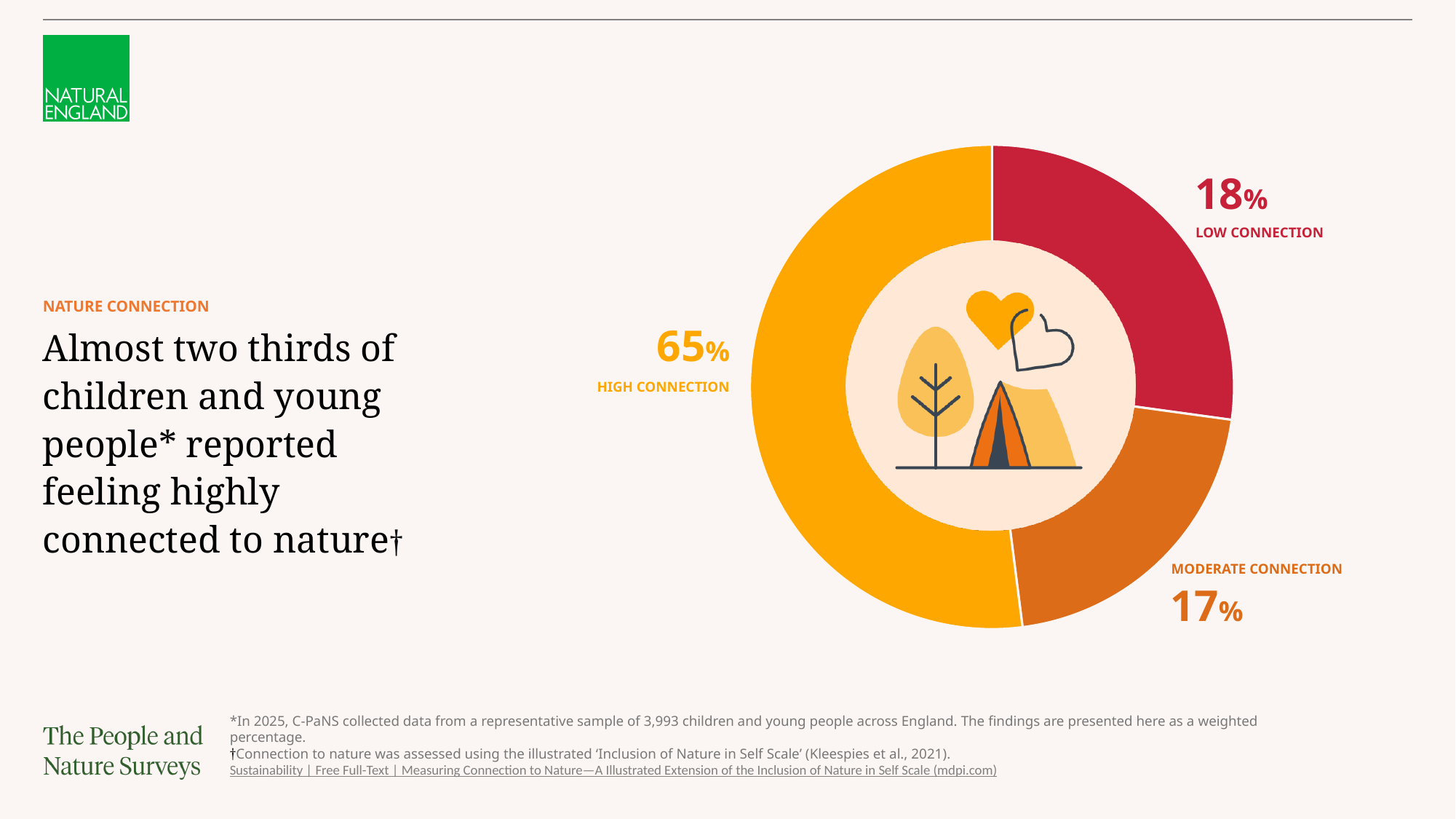
What percentage of children and young people reported a low connection to nature? 18% What percentage of children and young people reported a high connection to nature? 65% What percentage of children and young people reported a moderate connection to nature? 17% What is the combined share of low connection and moderate connection? 35% What is the difference in percentage points between high connection and low connection? 47 Which nature connection category has the largest share? High connection What kind of chart is shown on the slide? Pie chart (doughnut) How many categories does the chart show? 3 What colour is the low connection segment of the chart? Red Which nature connection category has the smallest share? Moderate connection What is the difference in percentage points between low connection and moderate connection? 1 Which is larger, the share for high connection or the share for moderate connection? High connection